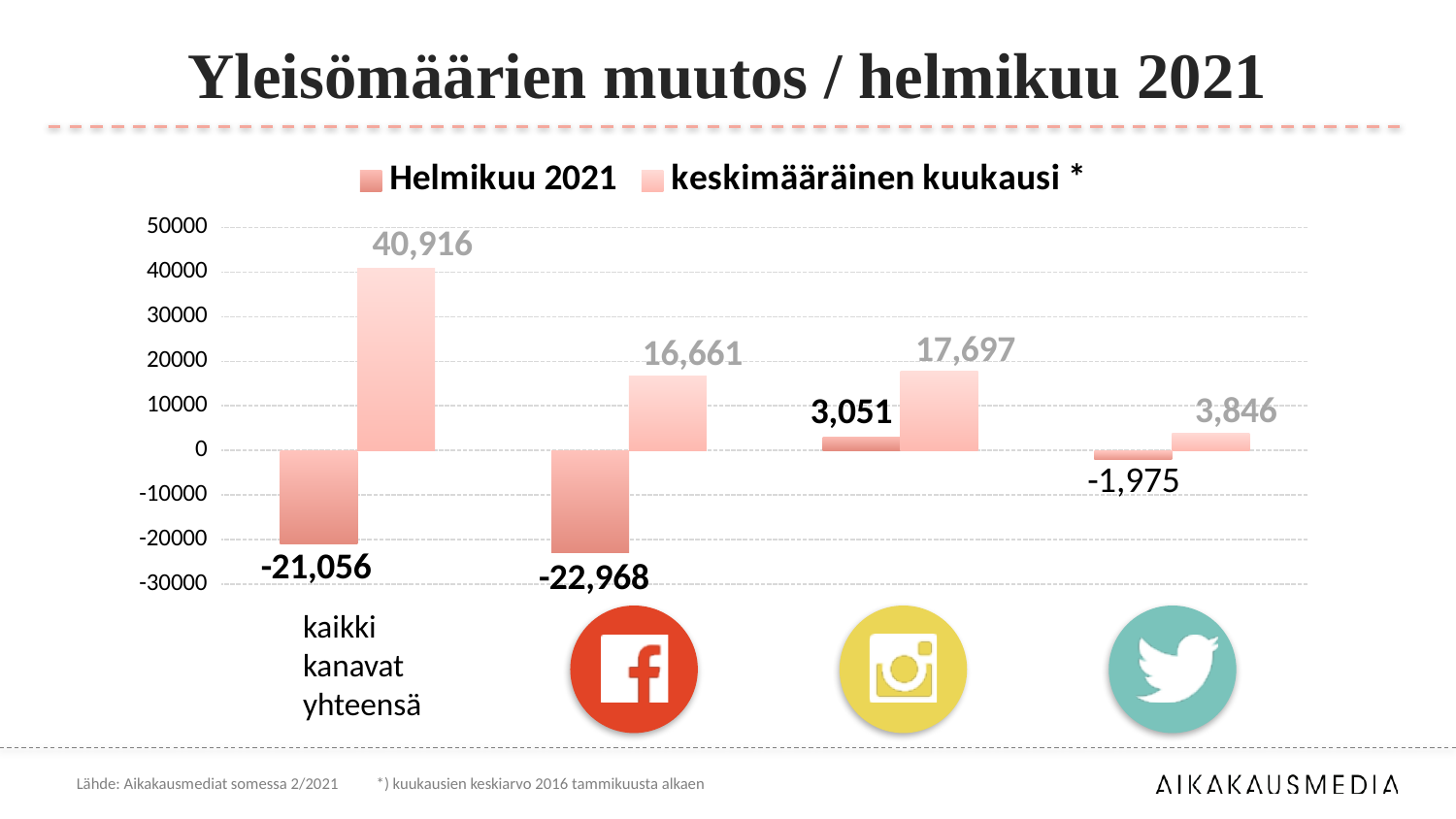
Which category has the highest keskimääräinen kuukausi value? kaikki kanavat yhteensä How many categories are shown on the x axis? 4 What is the Helmikuu 2021 value for the Twitter category? -1,975 Which category has the lowest Helmikuu 2021 value? Facebook What is the keskimääräinen kuukausi value for the Instagram category? 17,697 What is the Helmikuu 2021 value for the Facebook category? -22,968 What is the difference between the keskimääräinen kuukausi value and the Helmikuu 2021 value for the Instagram category? 14,646 What is the keskimääräinen kuukausi value for "kaikki kanavat yhteensä"? 40,916 How many series does the legend list? 2 What kind of chart is shown on the slide? bar chart What is the Helmikuu 2021 value for "kaikki kanavat yhteensä"? -21,056 Which is larger for the Facebook category: the Helmikuu 2021 value or the keskimääräinen kuukausi value? keskimääräinen kuukausi